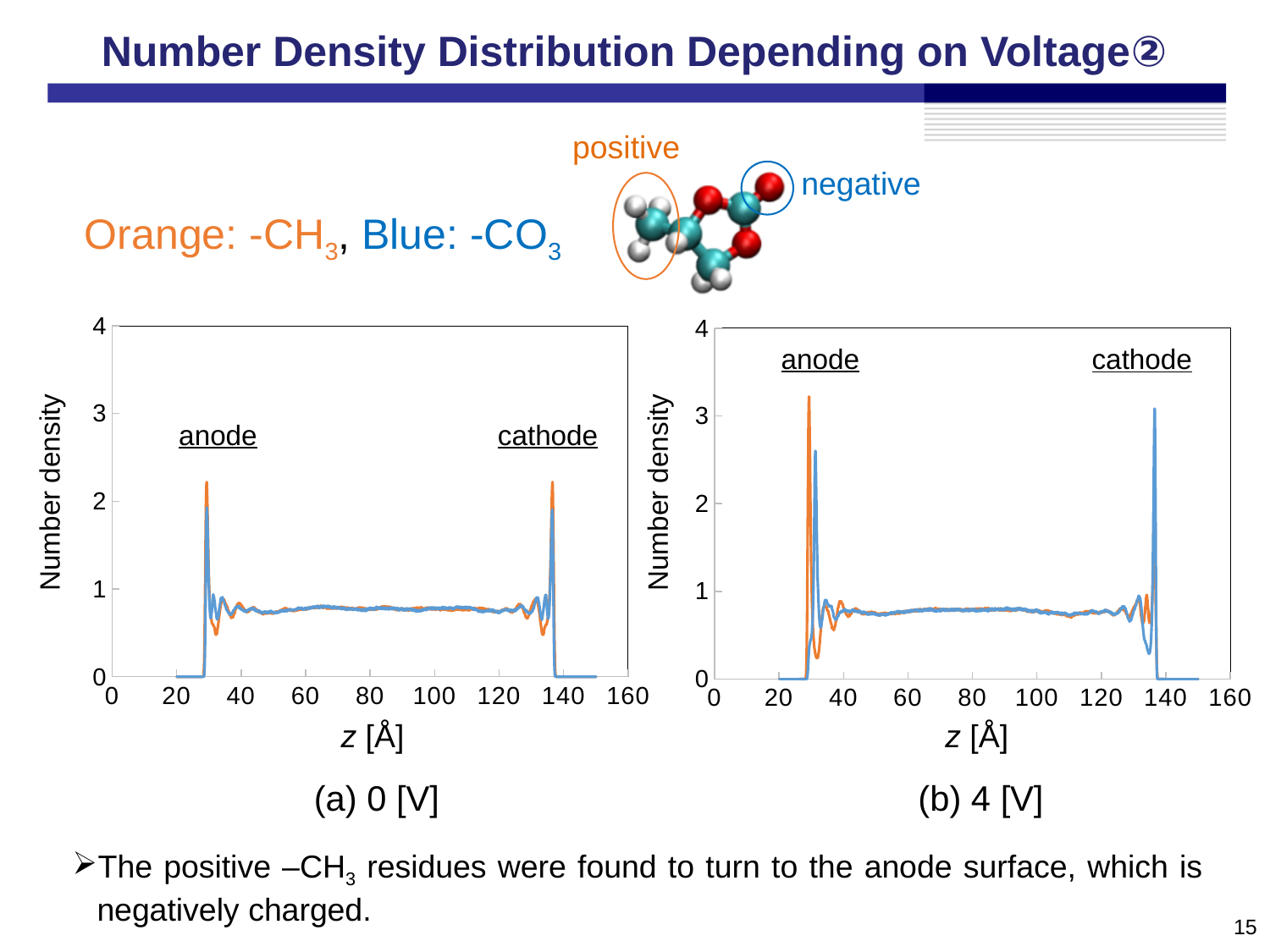
In chart (a) 0 [V], is the number density in the middle of the cell (around z = 80 Å) greater or less than 1? less In chart (b) 4 [V], is the peak value of the orange -CH3 curve near the anode greater or less than 3? greater How many series are plotted in chart (b) 4 [V]? 2 In chart (b) 4 [V], is the peak value of the blue -CO3 curve near the anode greater or less than 3? less What is the x-axis label of chart (b) 4 [V]? z [Å] In chart (b) 4 [V], which curve has the higher peak near the anode, orange -CH3 or blue -CO3? orange -CH3 What kind of chart is chart (a) 0 [V]? line chart What is the y-axis label of chart (a) 0 [V]? Number density